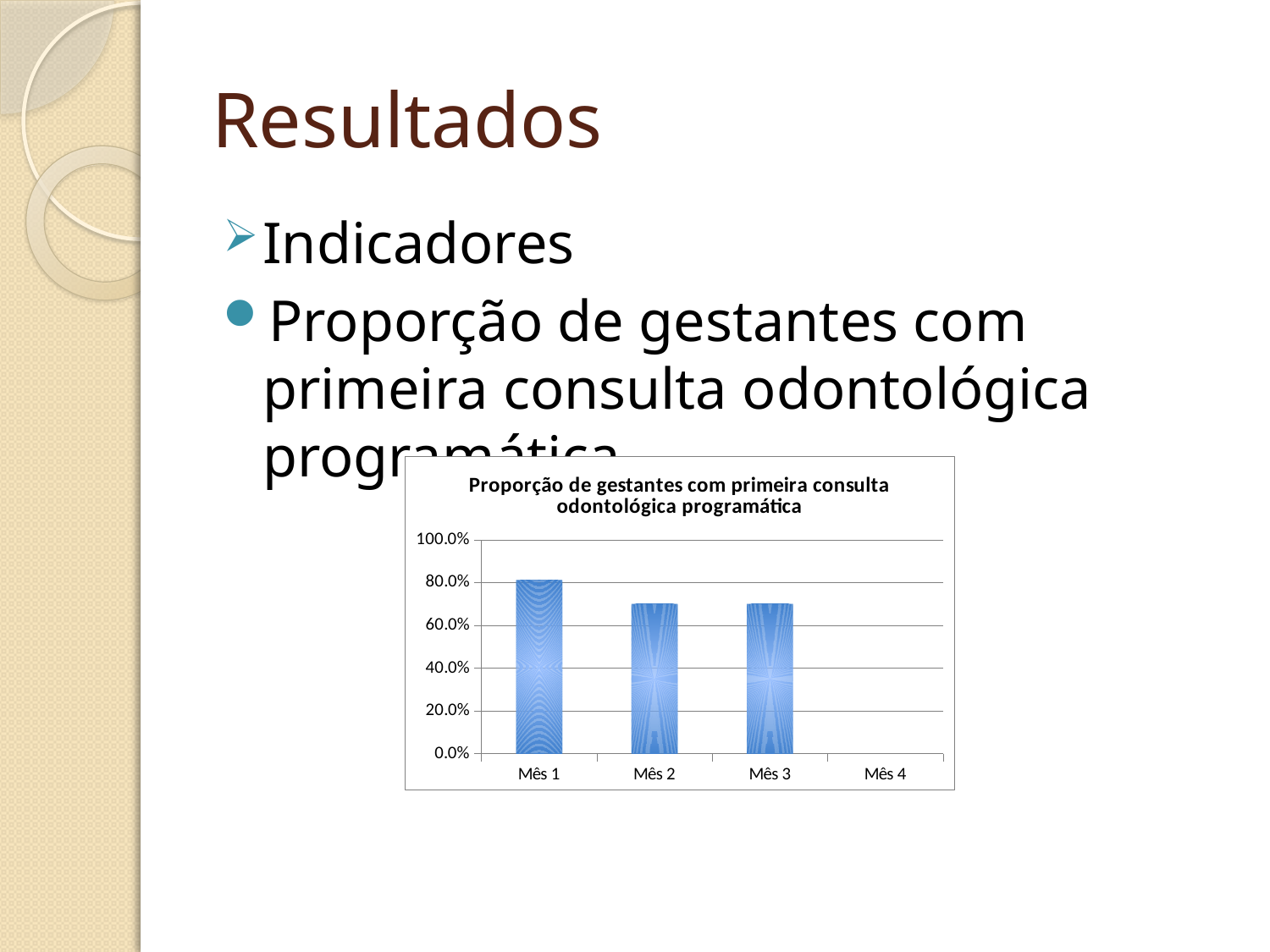
Do the values rise or fall from Mês 1 to Mês 4? fall Which is larger, the value for Mês 1 or the value for Mês 2? Mês 1 Which month has the highest value in the chart? Mês 1 What is the title of the chart? Proporção de gestantes com primeira consulta odontológica programática Is the value for Mês 1 greater or less than 60.0%? greater Is the value for Mês 3 greater or less than 60.0%? greater Is the value for Mês 2 greater or less than 40.0%? greater What kind of chart is shown on the slide? bar chart Which is larger, the value for Mês 3 or the value for Mês 4? Mês 3 How many categories are shown on the x axis of the chart? 4 Which month has the lowest value in the chart? Mês 4